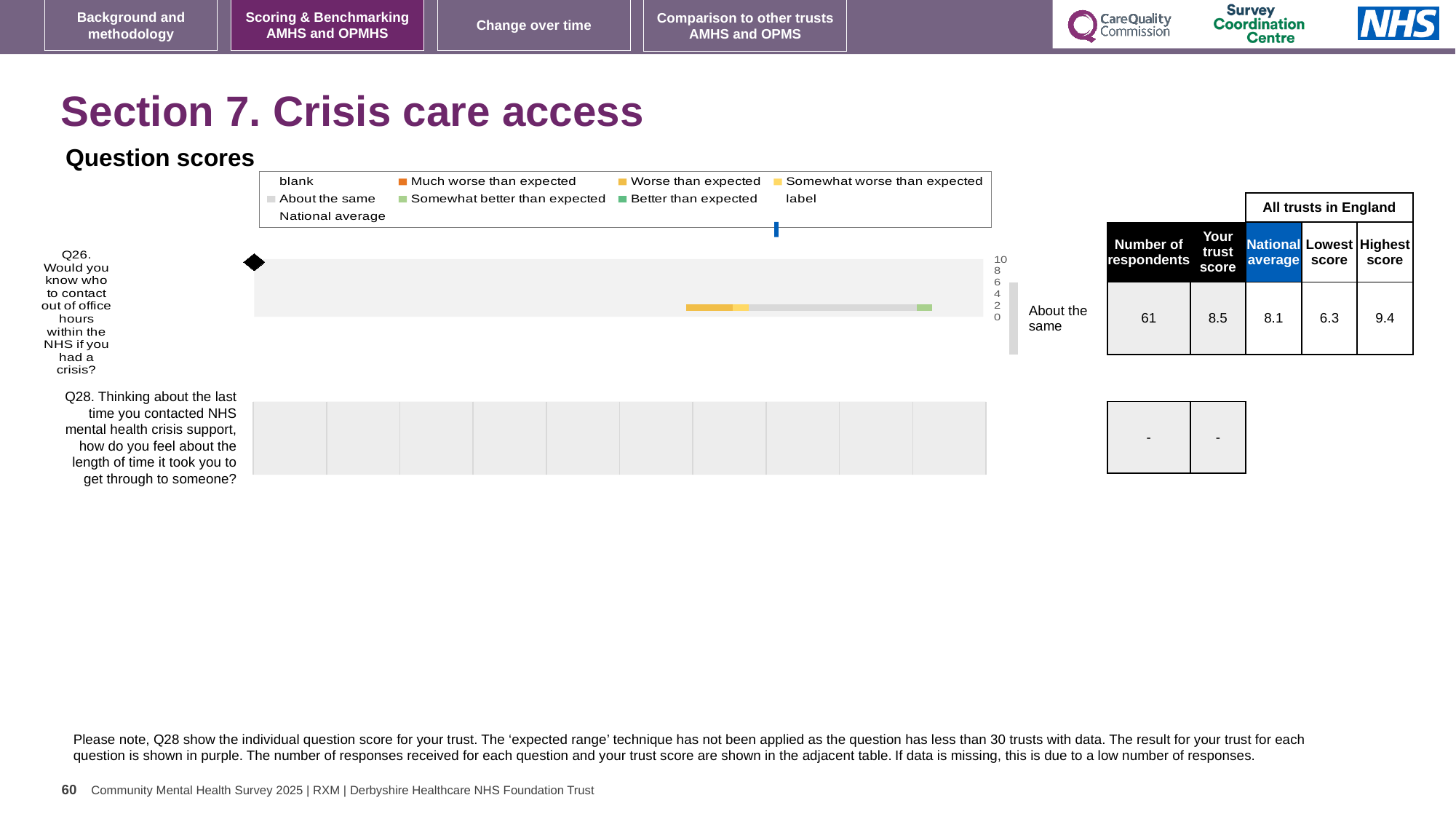
What is the difference between the trust score and the national average for Q26? 0.4 What is the lowest score among all trusts in England for Q26? 6.3 What is the trust score for Q26 shown in the table next to the chart? 8.5 How many respondents are recorded for Q26? 61 What is the difference between the highest and lowest scores for Q26 across all trusts in England? 3.1 What value is shown for the number of respondents and trust score for Q28? - For Q26, which is larger: the trust score or the national average? the trust score What is the highest score among all trusts in England for Q26? 9.4 What is the national average for Q26 shown in the table next to the chart? 8.1 What category label is shown next to the Q26 bar in the chart? About the same What kind of chart is used to show the question scores on this slide? bar chart How many questions are plotted in the question scores chart? 2